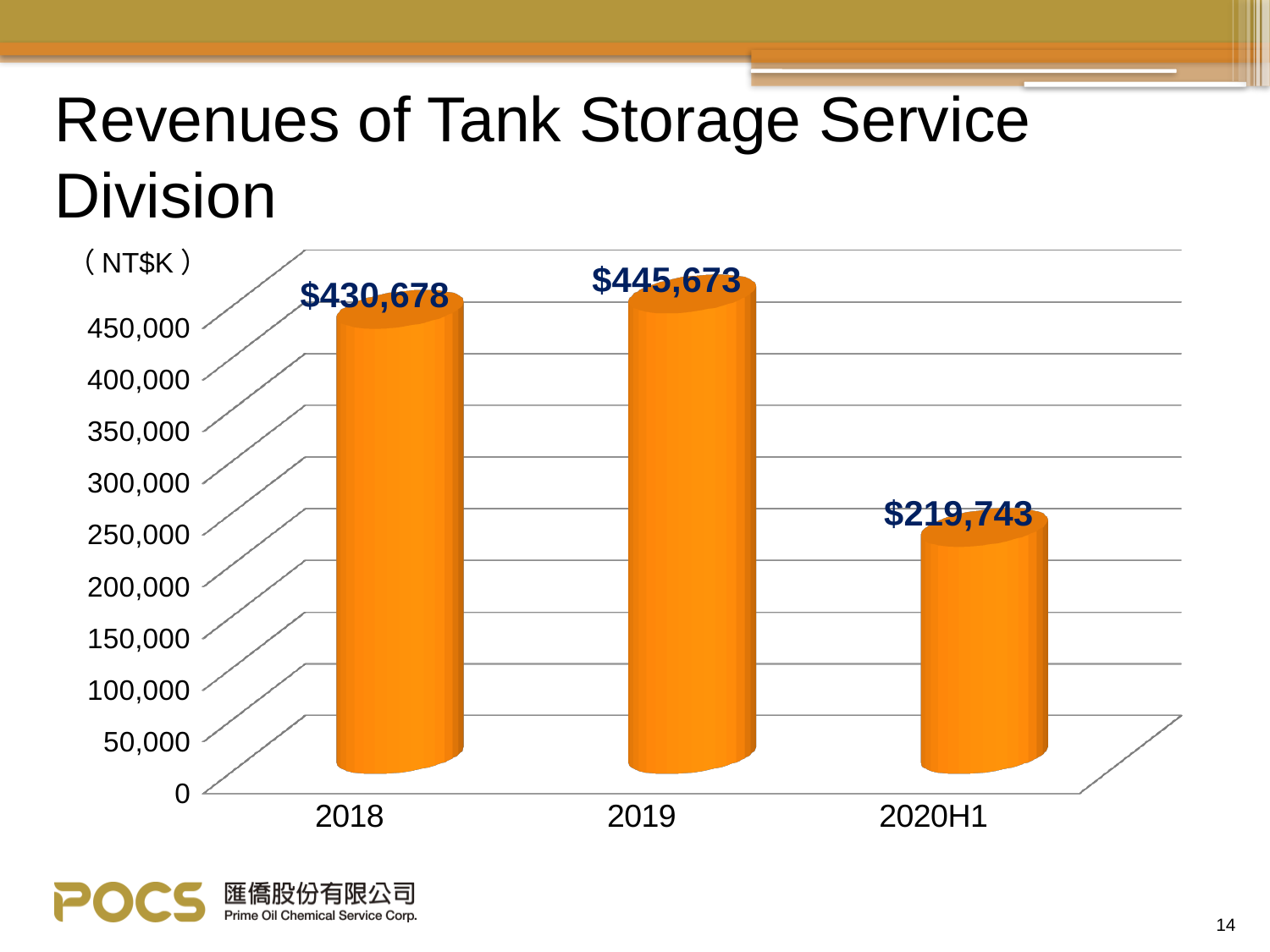
What is the difference between the 2018 and 2020H1 revenue values? $210,935 Which is larger, the revenue for 2018 or for 2020H1? 2018 What kind of chart is shown on the slide? Bar chart Is the value for 2020H1 greater or less than 250,000? less How many periods are shown on the x axis? 3 Which period has the lowest revenue? 2020H1 Which period has the highest revenue? 2019 What is the revenue value shown for 2020H1? $219,743 What unit is indicated for the values on the chart? NT$K What is the revenue value shown for 2018? $430,678 What is the revenue value shown for 2019? $445,673 What is the difference between the 2019 and 2018 revenue values? $14,995